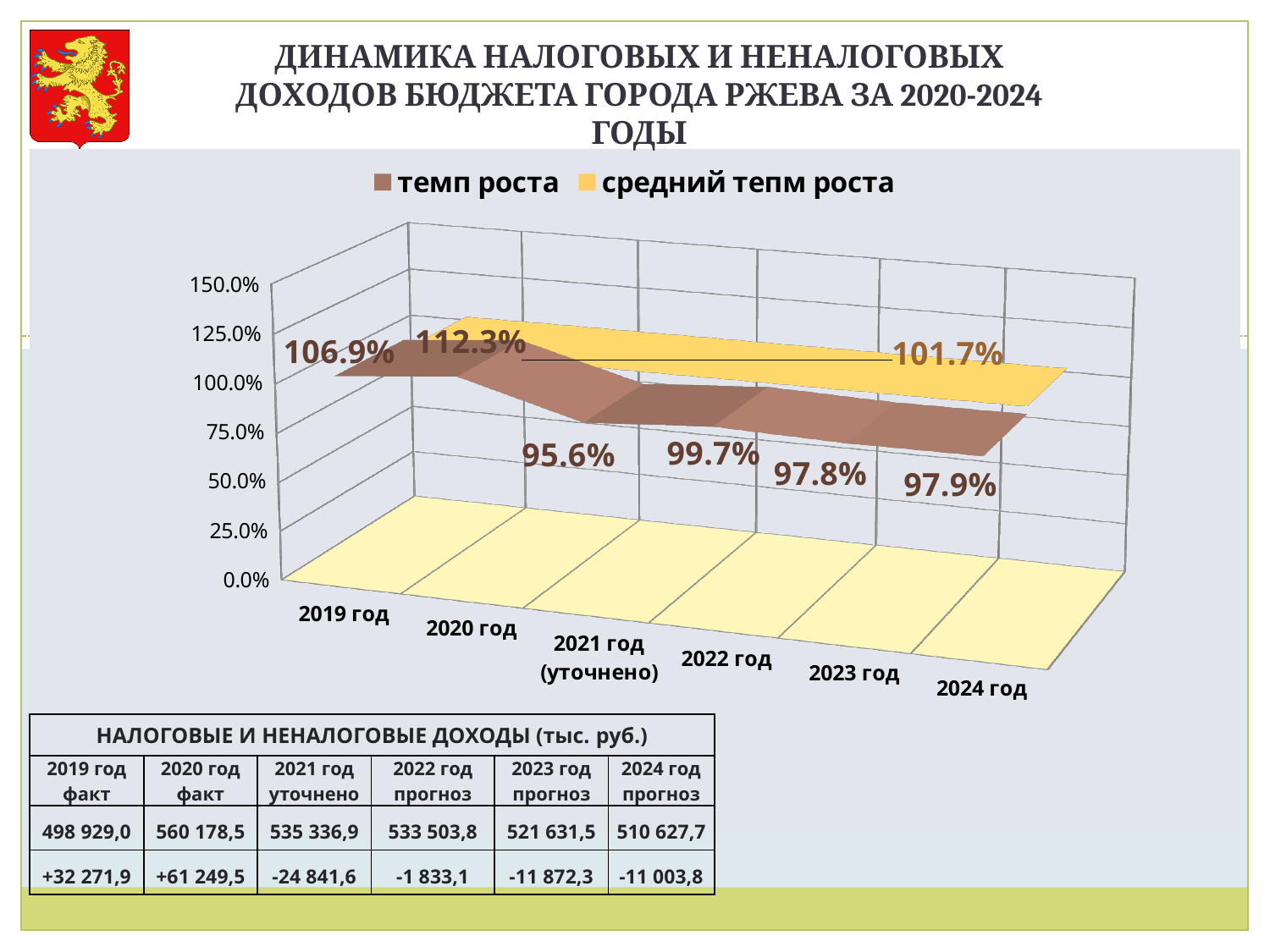
In which year is темп роста the highest? 2020 год What is the value of темп роста for 2020 год? 112.3% What value is labelled on the средний тепм роста series? 101.7% Which year has the higher темп роста, 2022 год or 2023 год? 2022 год Is the value of темп роста for 2019 год greater or less than 100.0%? greater By how many percentage points does темп роста in 2020 год exceed that in 2019 год? 5.4 percentage points What is the value of темп роста for 2021 год (уточнено)? 95.6% How many series does the chart legend list? 2 How many years are shown on the x axis of the chart? 6 What is the value of темп роста for 2024 год? 97.9% What kind of chart is shown on the slide? 3D line chart In which year is темп роста the lowest? 2021 год (уточнено)